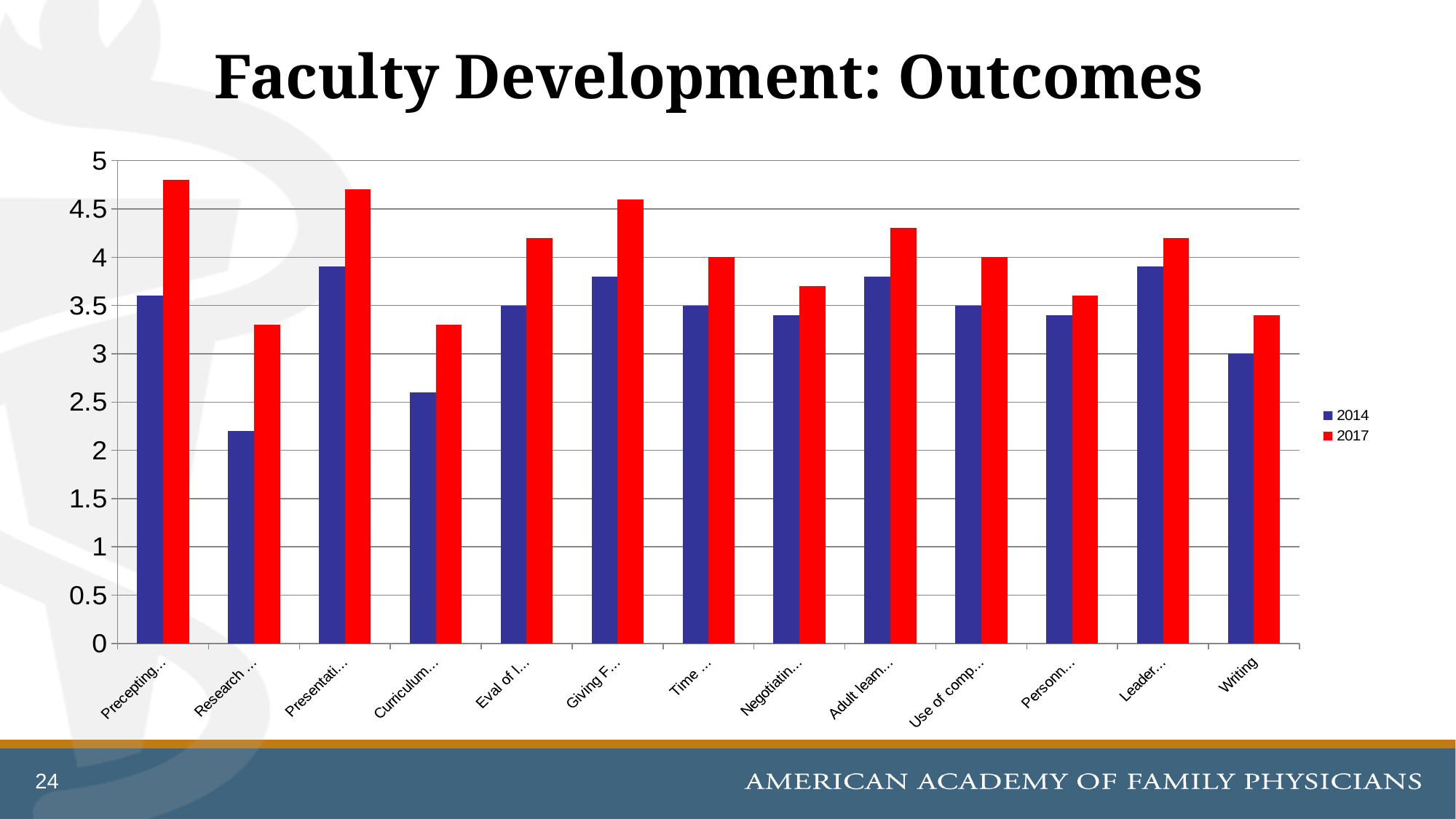
How many categories are shown along the x axis? 13 Is the 2014 value for Curriculum... greater or less than 3? less Which category has the highest 2017 value? Precepting... For Precepting..., which series has the larger value, 2014 or 2017? 2017 Is the 2014 value for Research ... greater or less than 2.5? less Is the 2017 value for Precepting... greater or less than 4.5? greater Which colour represents the 2017 series in the legend? red Which category has the lowest 2014 value? Research ... What is the 2014 value for Writing? 3 What kind of chart is shown on the slide? bar chart How many series does the legend list? 2